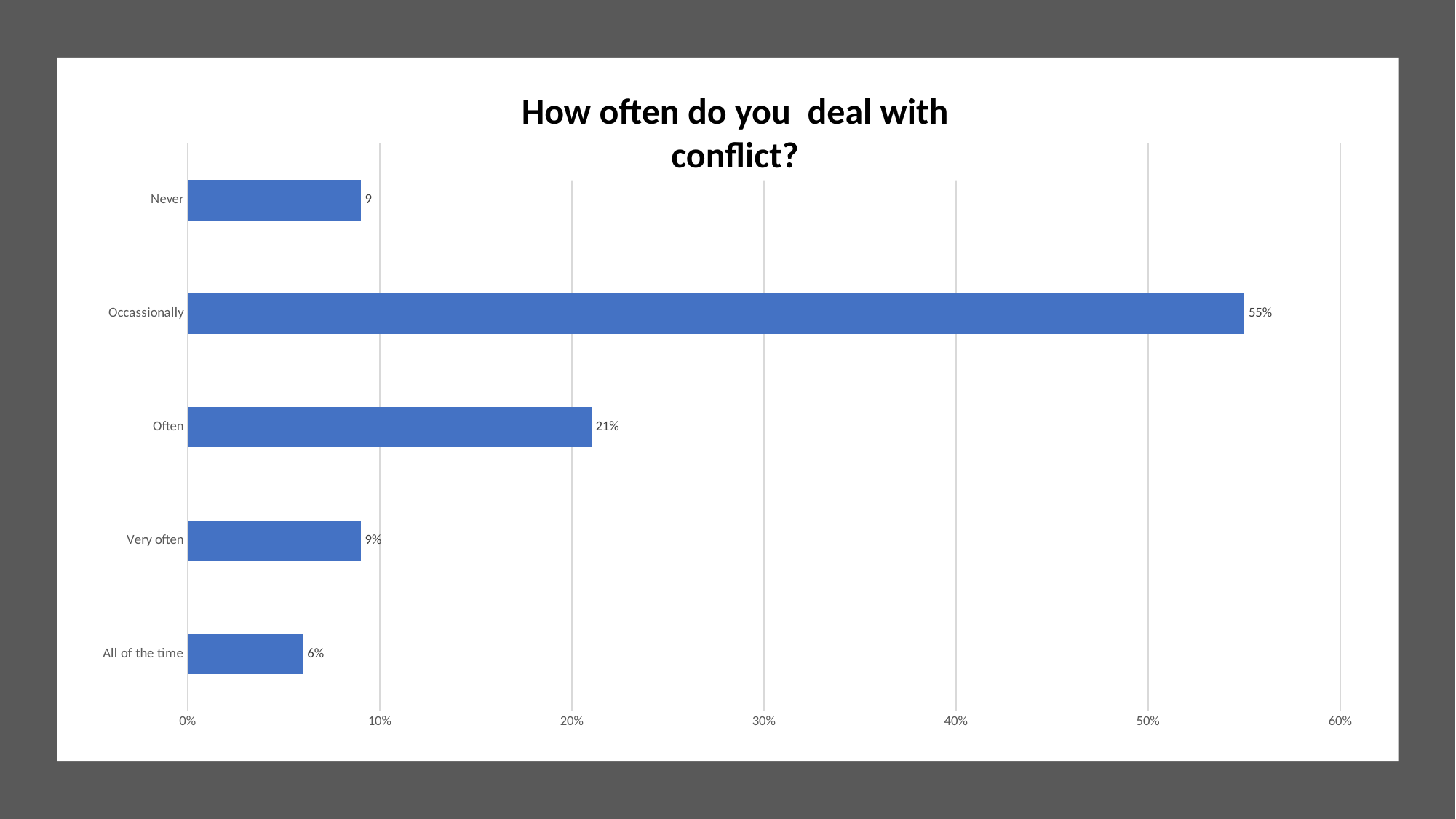
What is the value shown for All of the time? 6% What kind of chart is shown on the slide? Bar chart What data label is shown next to the Never bar? 9 What is the value shown for Occassionally? 55% Which category has the lowest value? All of the time What is the difference between the values for Occassionally and Often? 34% What is the title of the chart? How often do you deal with conflict? How many categories are shown on the chart? 5 What is the difference between the values for Very often and All of the time? 3% Which category has the highest value? Occassionally What is the value shown for Often? 21% Which is larger, the value for Often or the value for Very often? Often